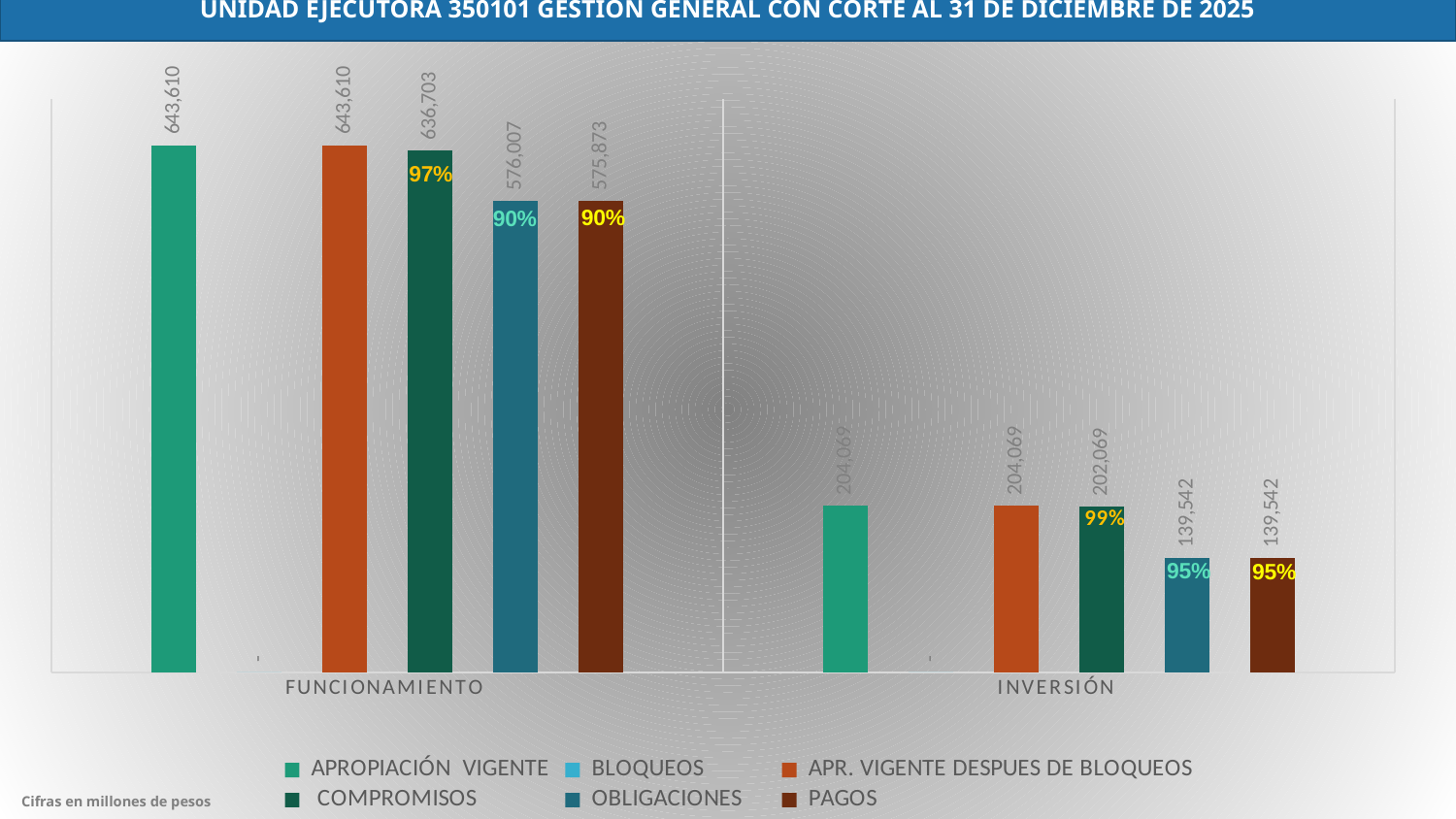
What is the value of COMPROMISOS for INVERSIÓN? 202,069 What is the value of OBLIGACIONES for FUNCIONAMIENTO? 576,007 What is the value of APROPIACIÓN VIGENTE for FUNCIONAMIENTO? 643,610 What is the difference between APROPIACIÓN VIGENTE and COMPROMISOS for INVERSIÓN? 2,000 What percentage is shown on the COMPROMISOS bar for FUNCIONAMIENTO? 97% How many categories are shown on the x axis? 2 What is the difference between APR. VIGENTE DESPUES DE BLOQUEOS and COMPROMISOS for FUNCIONAMIENTO? 6,907 What percentage is shown on the OBLIGACIONES bar for INVERSIÓN? 95% What type of chart is shown on the slide? Bar chart How many series does the legend list? 6 Which category has the higher APROPIACIÓN VIGENTE value, FUNCIONAMIENTO or INVERSIÓN? FUNCIONAMIENTO What is the value of PAGOS for INVERSIÓN? 139,542